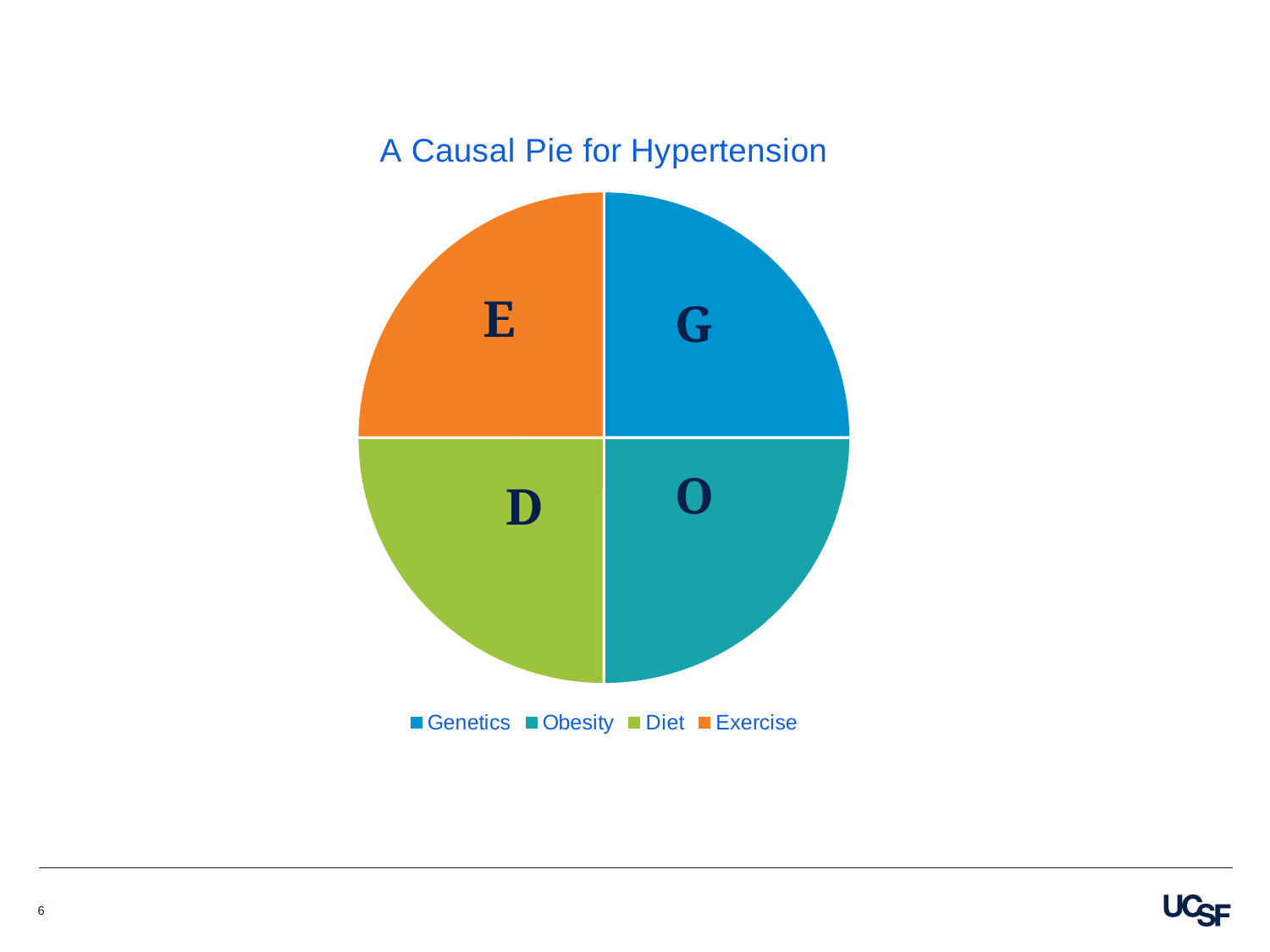
Which category is the slice labelled "E" in the pie chart? Exercise How many slices does the pie chart have? 4 Which category is the slice labelled "G" in the pie chart? Genetics Which category is the slice labelled "D" in the pie chart? Diet Which legend category does the orange slice of the pie chart represent? Exercise What letter is printed on the Diet slice of the pie chart? D How many entries does the legend of the pie chart list? 4 What letter is printed on the Genetics slice of the pie chart? G Which category is the slice labelled "O" in the pie chart? Obesity What kind of chart is shown on the slide? pie chart What is the title of the pie chart? A Causal Pie for Hypertension